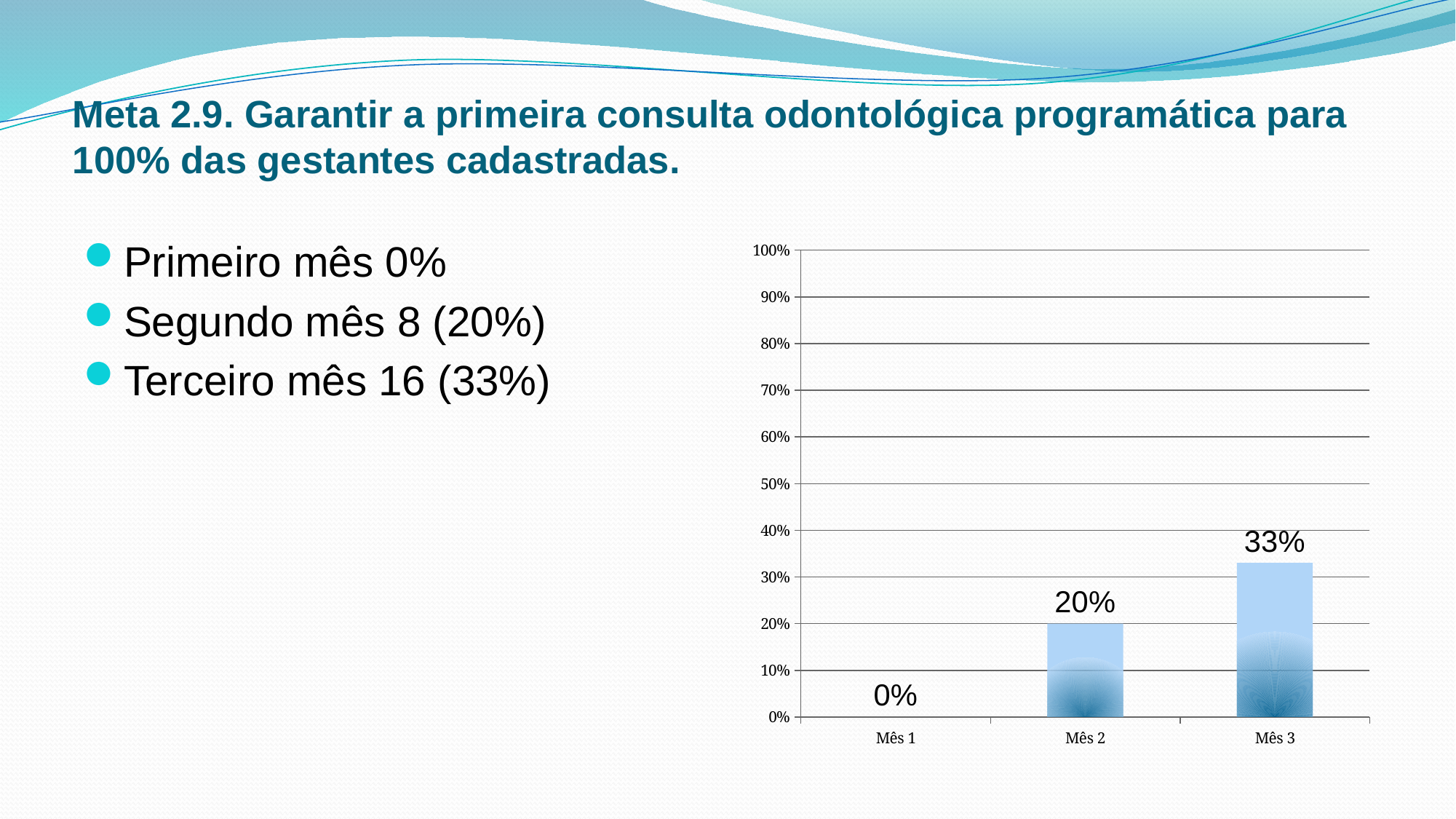
Do the values rise or fall from Mês 1 to Mês 3? rise Which is larger, the value for Mês 2 or the value for Mês 3? Mês 3 What is the difference between the values for Mês 3 and Mês 2? 13% Which category has the highest value? Mês 3 What is the highest value shown on the y axis? 100% What is the value for Mês 2? 20% Is the value for Mês 3 greater or less than 40%? less How many categories are shown on the x axis? 3 What is the value for Mês 1? 0% What kind of chart is shown on the slide? bar chart What is the value for Mês 3? 33% Which category has the lowest value? Mês 1